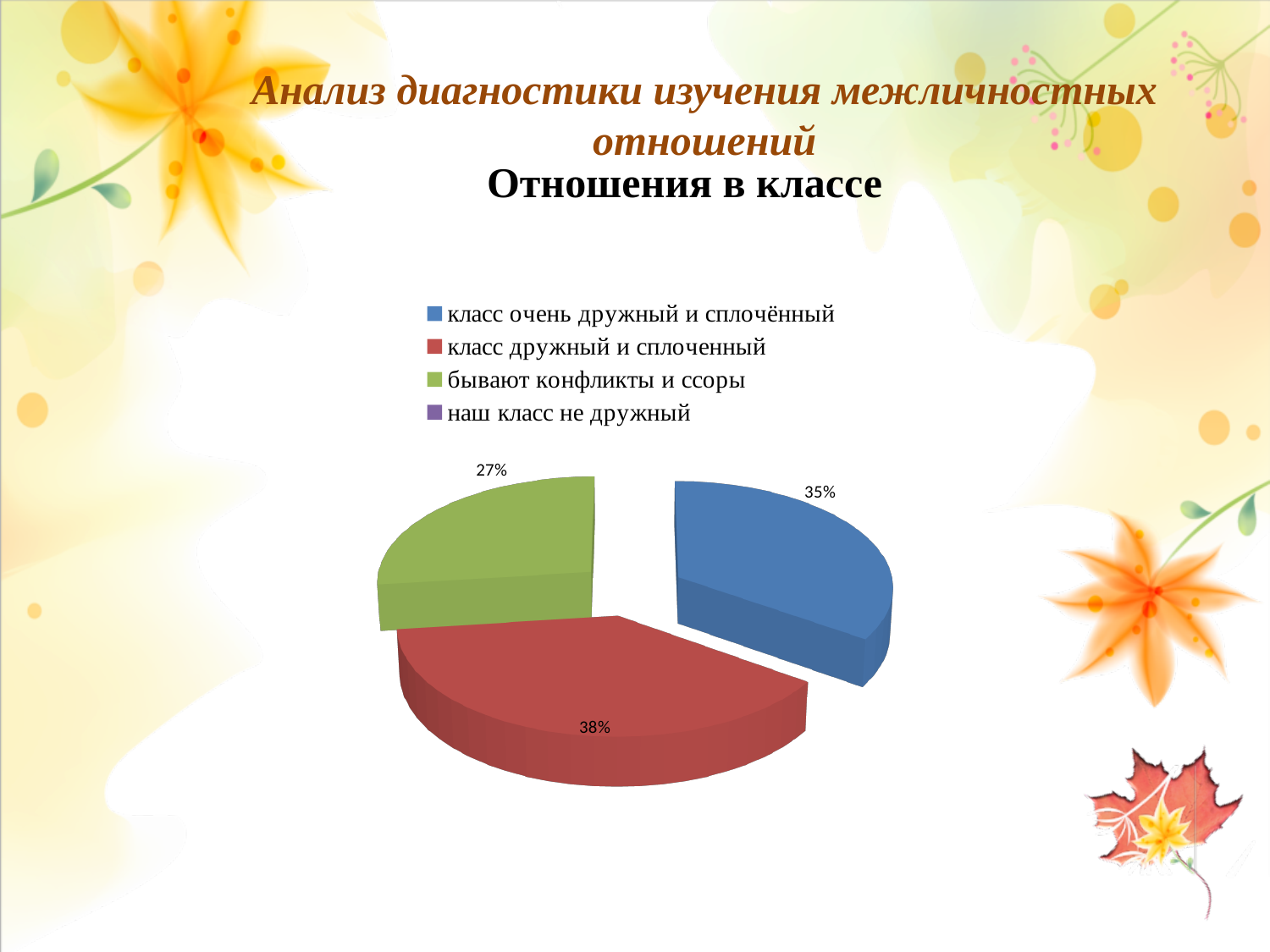
What is the difference in percentage points between the slices for "класс дружный и сплоченный" and "класс очень дружный и сплочённый"? 3 How many entries does the legend list? 4 Which of the labelled slices is the smallest? бывают конфликты и ссоры What is the title of the chart? Отношения в классе What share of the pie is labelled for "класс очень дружный и сплочённый"? 35% What colour is the slice for "бывают конфликты и ссоры"? green What share of the pie is labelled for "бывают конфликты и ссоры"? 27% What kind of chart is shown on the slide? pie chart How many slices with percentage labels are visible in the pie? 3 Which category has the largest slice of the pie? класс дружный и сплоченный Which is larger: the slice for "класс очень дружный и сплочённый" or the slice for "бывают конфликты и ссоры"? класс очень дружный и сплочённый What share of the pie is labelled for "класс дружный и сплоченный"? 38%